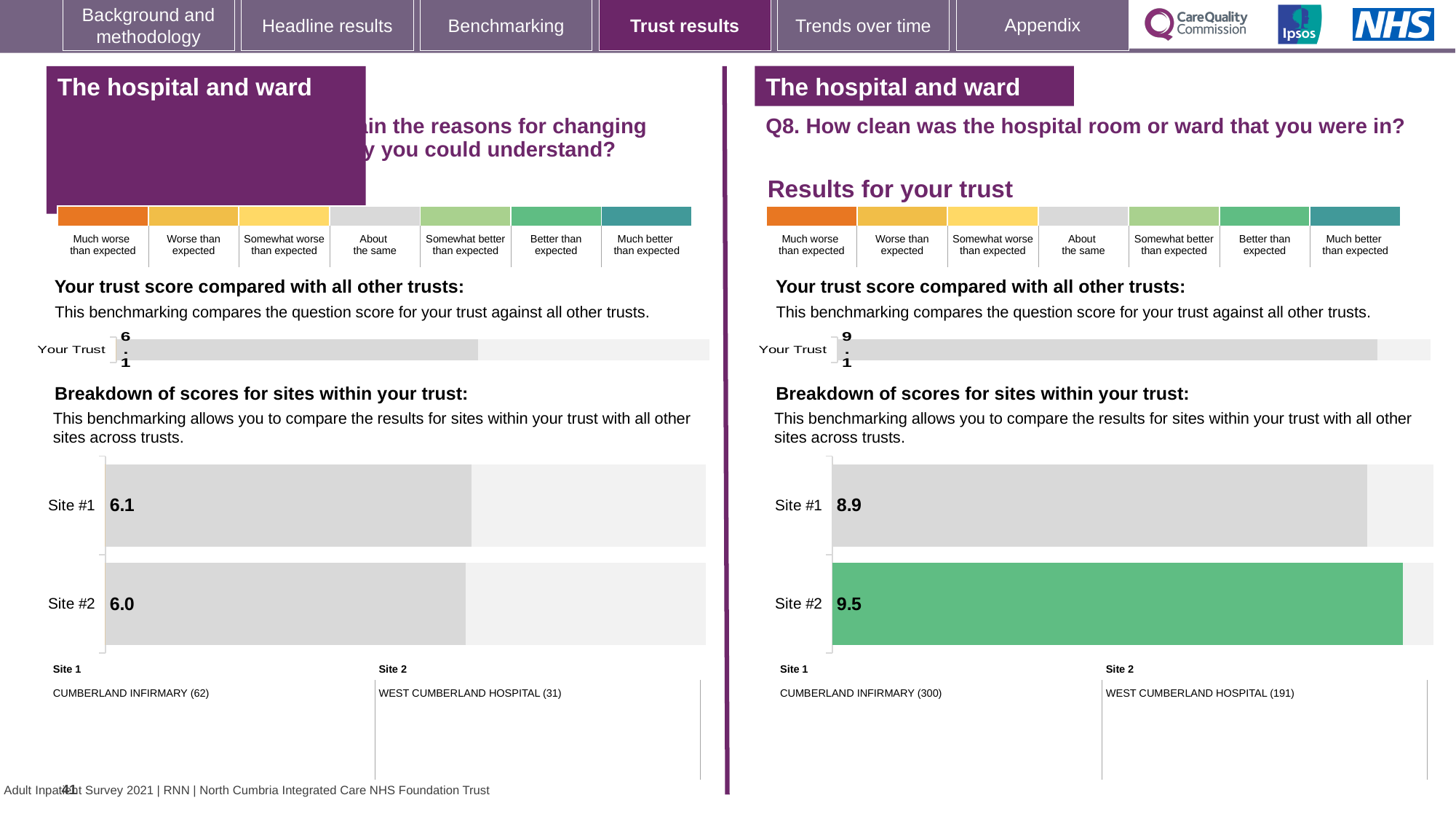
On the Q8 site breakdown chart, what is the difference between the Site #2 and Site #1 scores? 0.6 How many sites are shown in the Q8 site breakdown chart? 2 On the Q8 site breakdown chart, what is the score for Site #1? 8.9 On the left-hand site breakdown chart, what is the score for Site #2? 6.0 On the Q8 site breakdown chart, what is the score for Site #2? 9.5 On the left-hand site breakdown chart, what is the difference between the Site #1 and Site #2 scores? 0.1 On the left-hand site breakdown chart, which site has the lower score? Site #2 What type of chart is used for the Q8 site breakdown? Bar chart On the Q8 site breakdown chart, which site has the higher score? Site #2 On the Q8 site breakdown chart, which site's bar is coloured green? Site #2 On the left-hand chart, what is the score for Your Trust? 6.1 On the right-hand (Q8) chart, what is the score for Your Trust? 9.1